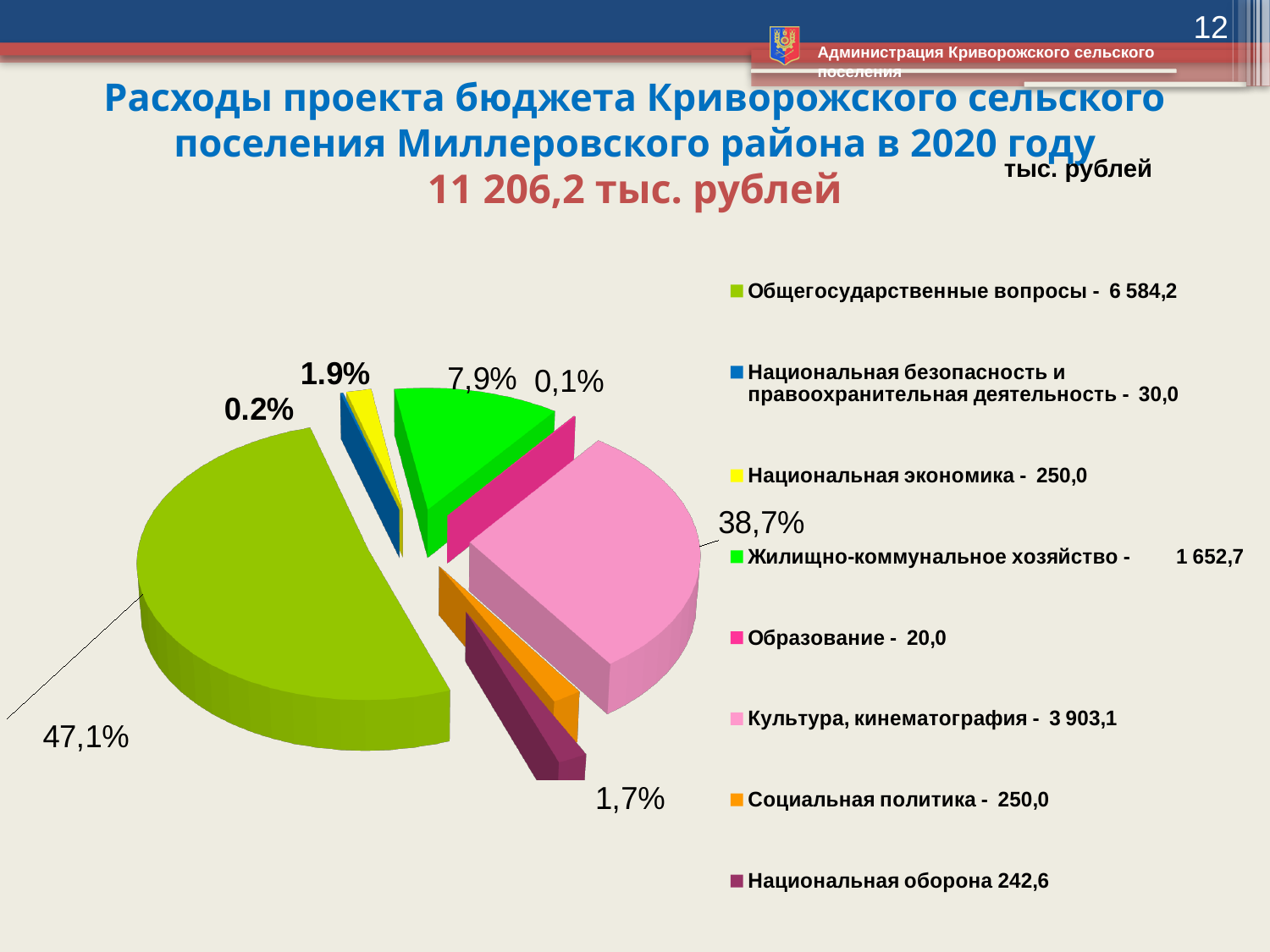
What value is given in the legend for Национальная оборона? 242,6 What is the difference between the values for Культура, кинематография and Жилищно-коммунальное хозяйство? 2 250,4 Which category has the largest value in the pie chart? Общегосударственные вопросы What value is given in the legend for Жилищно-коммунальное хозяйство? 1 652,7 What percentage label is attached to the largest (green) slice of the pie? 47,1% What value is given in the legend for Общегосударственные вопросы? 6 584,2 Which is larger: Национальная экономика or Национальная безопасность и правоохранительная деятельность? Национальная экономика What kind of chart is shown on the slide? pie chart Which category has the smallest value in the pie chart? Образование How many categories does the legend of the pie chart list? 8 What value is given in the legend for Культура, кинематография? 3 903,1 In what units are the values on the slide expressed? тыс. рублей